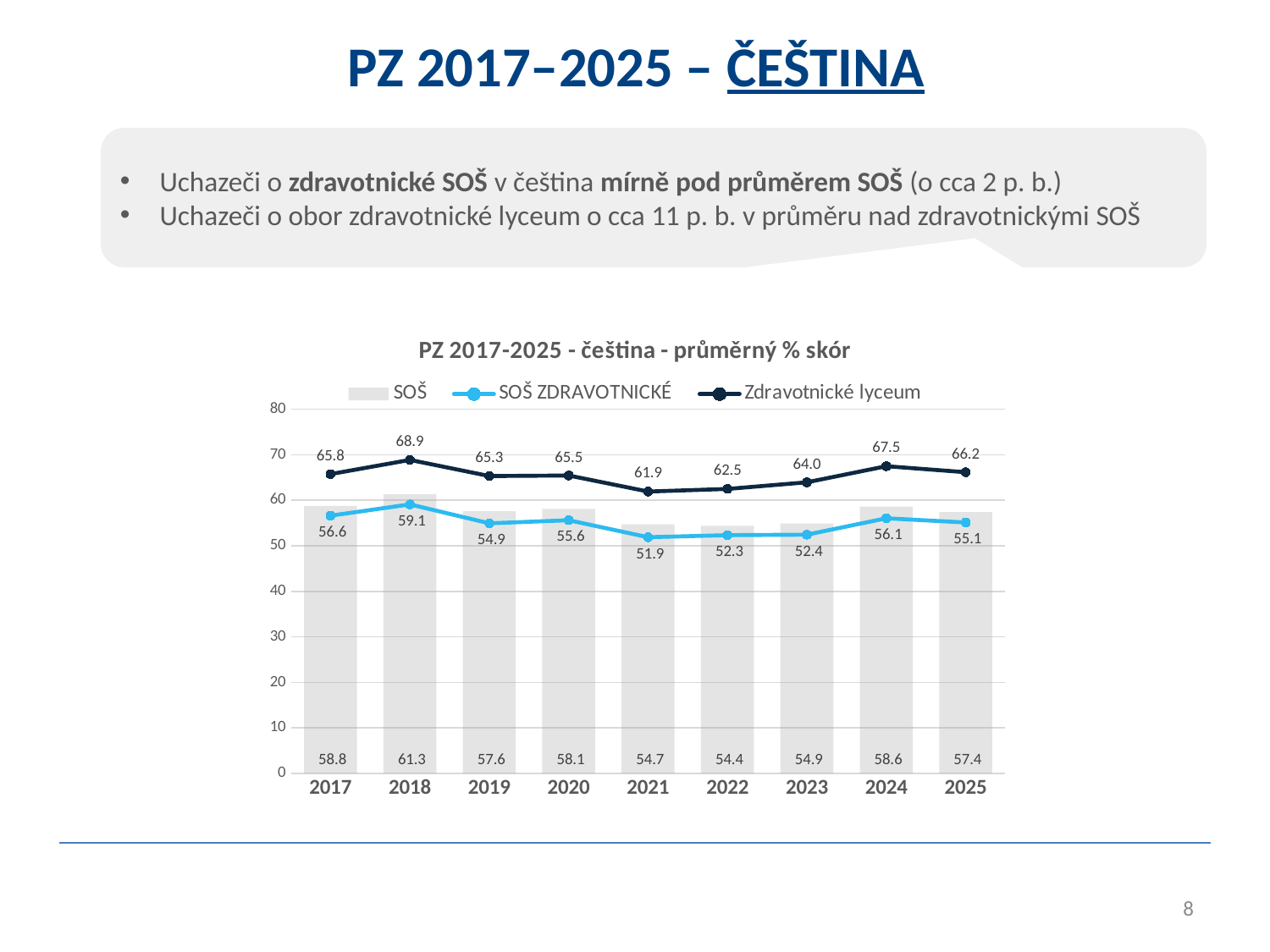
How many years are shown on the x axis? 9 What is the difference between the Zdravotnické lyceum and SOŠ ZDRAVOTNICKÉ values in 2025? 11.1 What is the title of the chart? PZ 2017-2025 - čeština - průměrný % skór What is the SOŠ value for 2018? 61.3 How many series does the legend list? 3 What kind of chart is this? Combined bar and line chart Which is larger in 2019: the SOŠ value or the SOŠ ZDRAVOTNICKÉ value? SOŠ What is the Zdravotnické lyceum value for 2024? 67.5 In which year is the SOŠ ZDRAVOTNICKÉ value lowest? 2021 In which year is the Zdravotnické lyceum value highest? 2018 What is the SOŠ ZDRAVOTNICKÉ value for 2021? 51.9 Is the SOŠ value for 2022 greater or less than 60? less